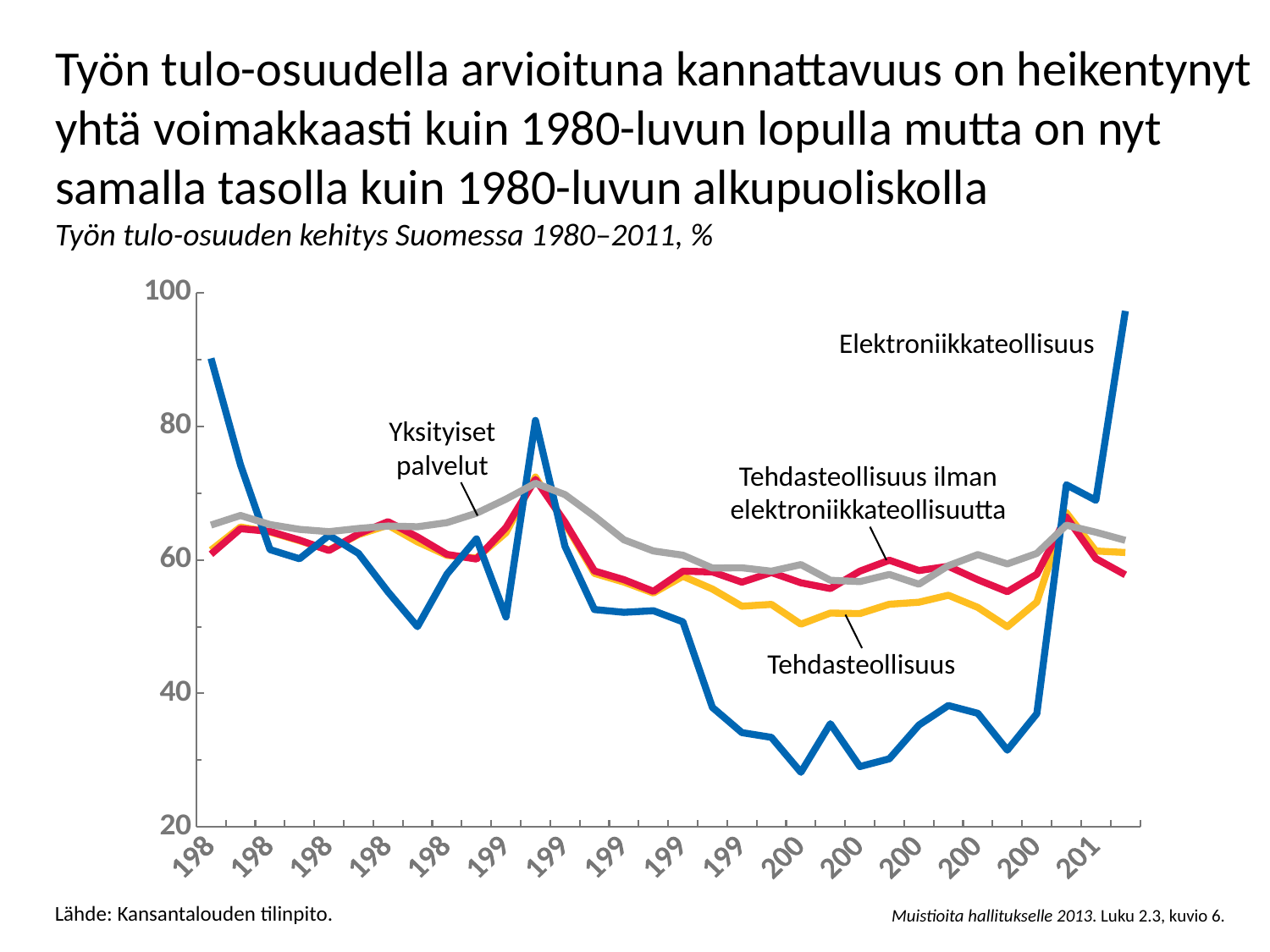
Is the value for Yksityiset palvelut at the start of the series (1980) greater or less than 60? greater Does the Elektroniikkateollisuus line rise or fall over the last few years of the series (towards 2011)? Rises How many series (labelled lines) are plotted on the chart? 4 Is the value for Tehdasteollisuus in the early 2000s greater or less than 60? less What colour is the Elektroniikkateollisuus line? Blue Is the lowest value of Elektroniikkateollisuus in the early 2000s greater or less than 40? less What is the subtitle of the chart? Työn tulo-osuuden kehitys Suomessa 1980–2011, % During the 2000s, which line is higher: Tehdasteollisuus or Tehdasteollisuus ilman elektroniikkateollisuutta? Tehdasteollisuus ilman elektroniikkateollisuutta What kind of chart is shown on the slide? Line chart Which series reaches the lowest value anywhere on the chart? Elektroniikkateollisuus Which series reaches the highest value anywhere on the chart? Elektroniikkateollisuus